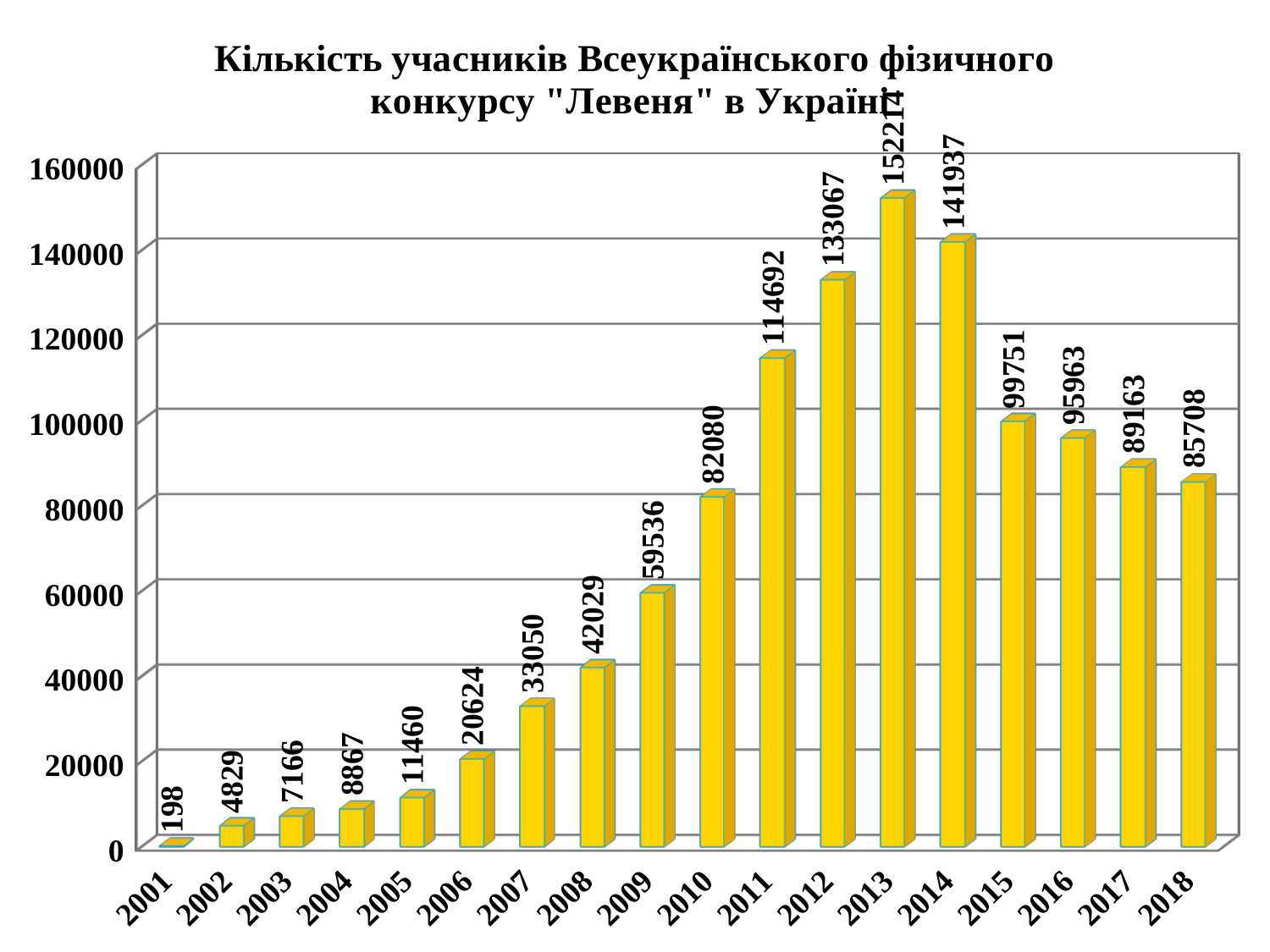
What is the number of participants in 2014? 141937 What is the number of participants in 2010? 82080 What kind of chart is shown on the slide? bar chart Which year has more participants, 2015 or 2016? 2015 What is the difference between the number of participants in 2012 and in 2011? 18375 Which year has the highest number of participants? 2013 What is the number of participants in 2001? 198 What is the number of participants in 2018? 85708 Which year has the lowest number of participants? 2001 Is the value for 2009 greater or less than 60000? less How many years are shown on the x axis of the chart? 18 Do the values rise or fall from 2014 to 2018? fall